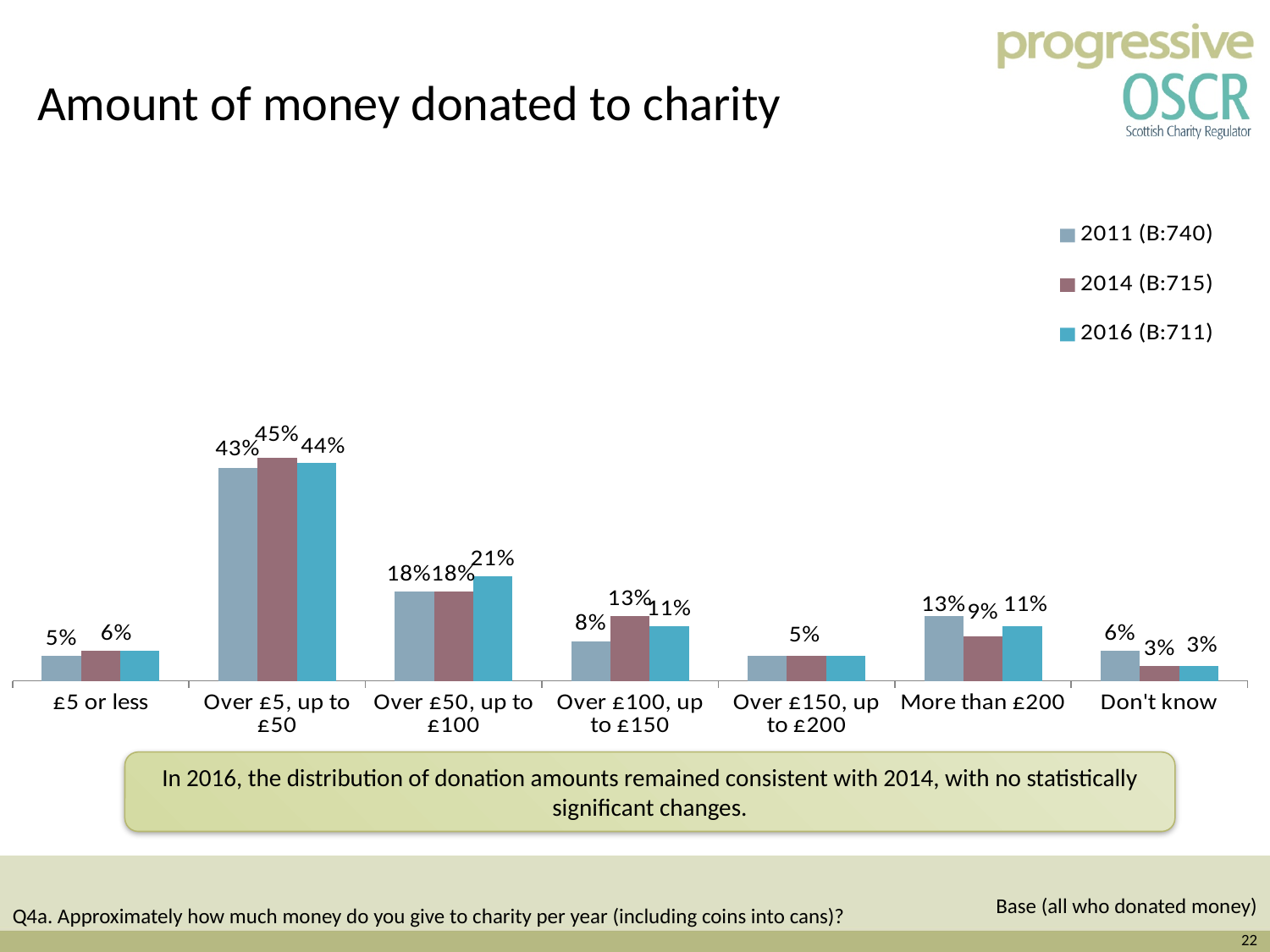
What was the 2011 value for 'More than £200'? 13% What percentage of respondents in 2016 donated over £50, up to £100? 21% What percentage answered 'Don't know' in 2011? 6% How many series does the legend list? 3 By how many percentage points did the 'Over £50, up to £100' value change from 2011 to 2016? 3 percentage points For 'More than £200', which year had the larger value, 2011 or 2014? 2011 What type of chart is shown on the slide? Bar chart What was the 2014 value for the 'Over £5, up to £50' category? 45% Which donation category had the highest value in 2016? Over £5, up to £50 How many donation categories are shown on the x axis? 7 What was the 2014 value for 'Over £100, up to £150'? 13% What is the base size shown in the legend for the 2016 series? 711